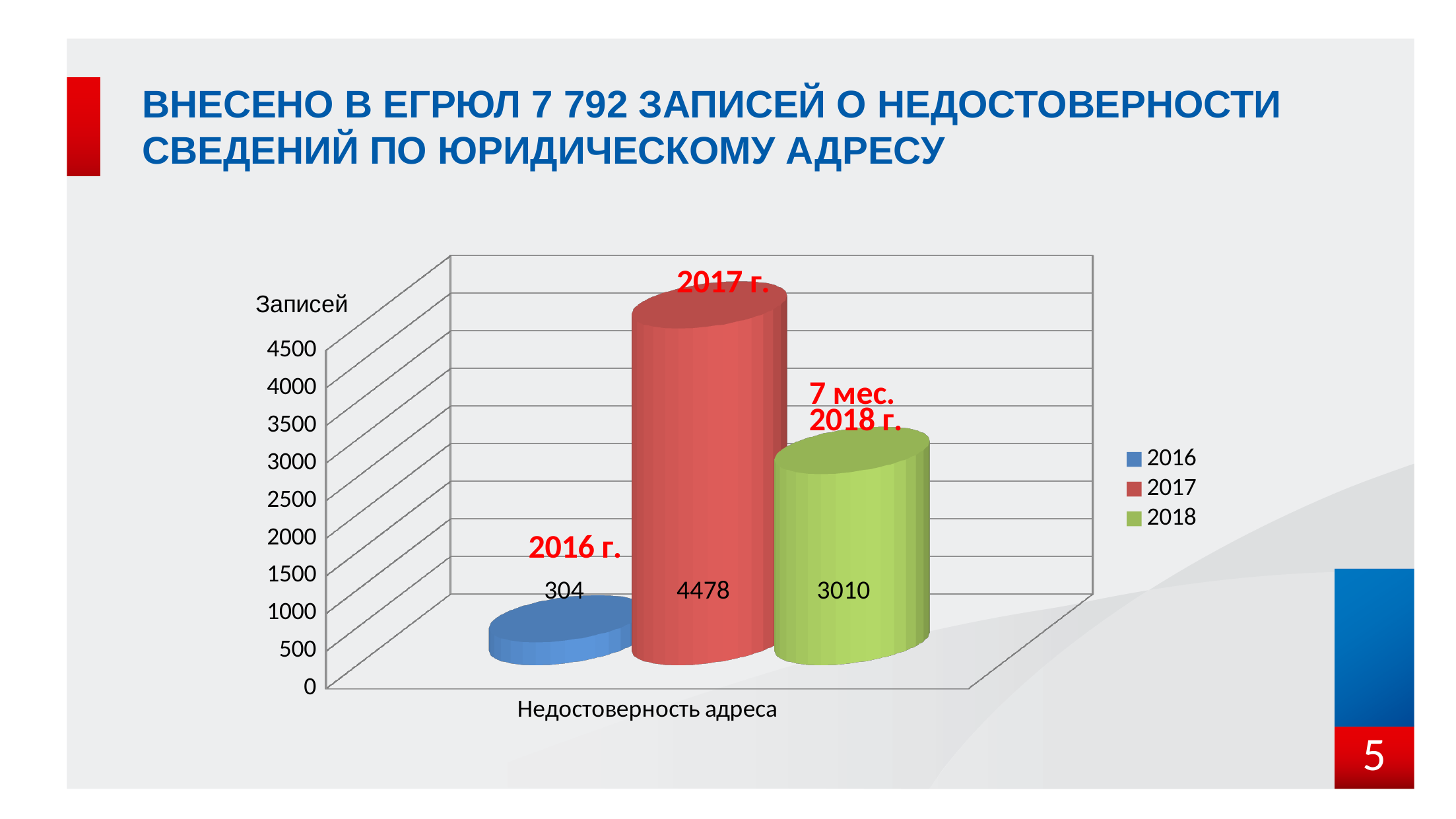
What is the difference between the values for 2017 and 2018? 1468 What is the category label on the x axis of the chart? Недостоверность адреса Which year has the lowest value in the chart? 2016 How many series does the legend list? 3 Is the value for 2017 greater or less than 4000? greater Which is larger, the value for 2017 or the value for 2018? 2017 What is the value for 2018 in the chart? 3010 What is the value for 2017 in the chart? 4478 What is the difference between the values for 2018 and 2016? 2706 Which year has the highest value in the chart? 2017 What is the value for 2016 in the chart? 304 What kind of chart is shown on the slide? bar chart